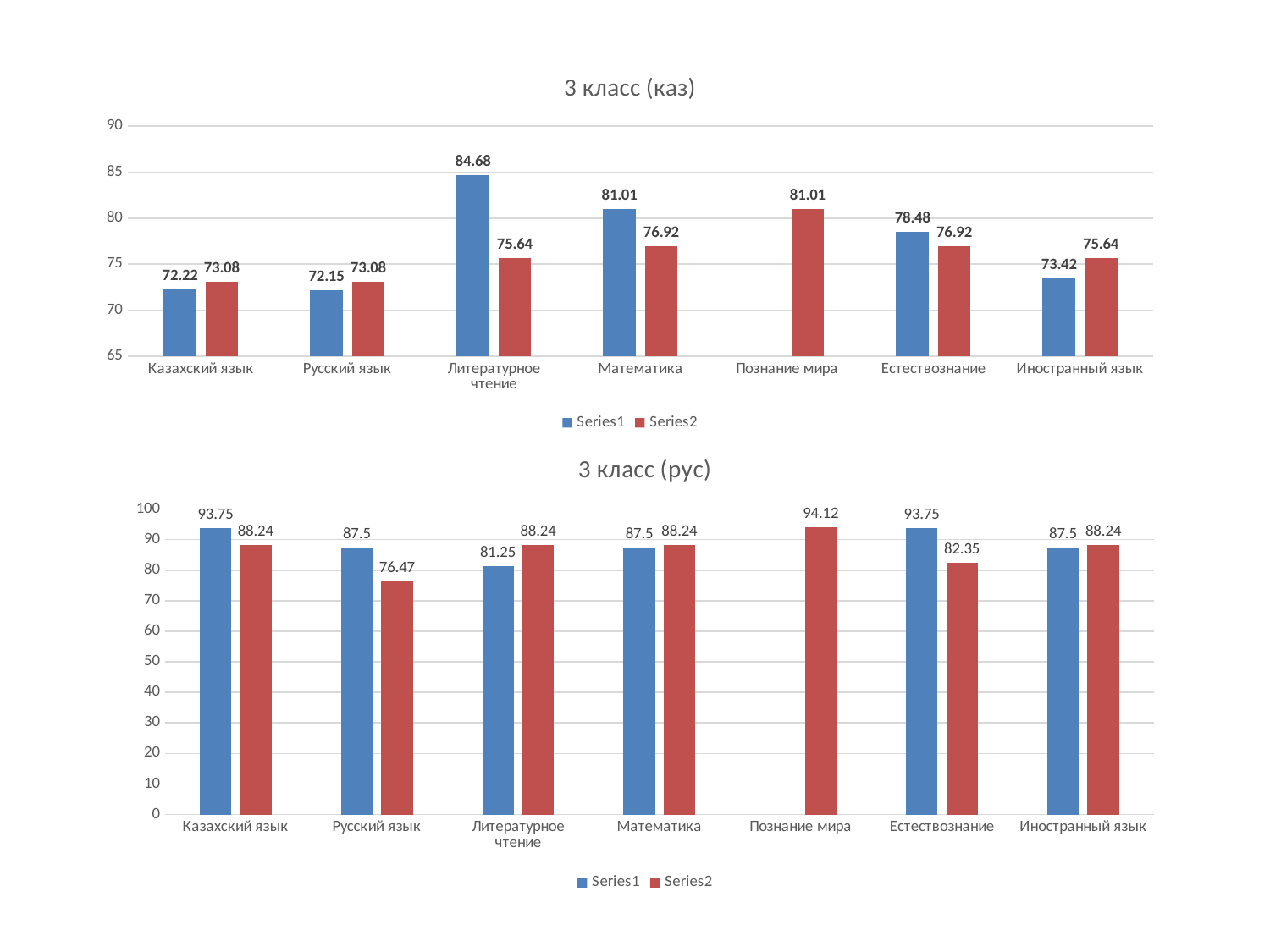
In the chart titled "3 класс (каз)", how many categories are shown on the x axis? 7 In the chart titled "3 класс (рус)", how many series does the legend list? 2 In the chart titled "3 класс (каз)", what is the Series1 value for Литературное чтение? 84.68 In the chart titled "3 класс (рус)", what is the difference between the Series1 and Series2 values for Естествознание? 11.4 In the chart titled "3 класс (каз)", which is larger for Иностранный язык: Series1 or Series2? Series2 What type of chart is the chart titled "3 класс (рус)"? Bar chart In the chart titled "3 класс (каз)", what is the Series2 value for Познание мира? 81.01 In the chart titled "3 класс (каз)", which category has the highest Series1 value? Литературное чтение In the chart titled "3 класс (рус)", what is the Series2 value for Русский язык? 76.47 In the chart titled "3 класс (каз)", what is the difference between the Series1 and Series2 values for Математика? 4.09 In the chart titled "3 класс (рус)", which category has the lowest Series1 value? Литературное чтение In the chart titled "3 класс (рус)", which category has the highest Series2 value? Познание мира